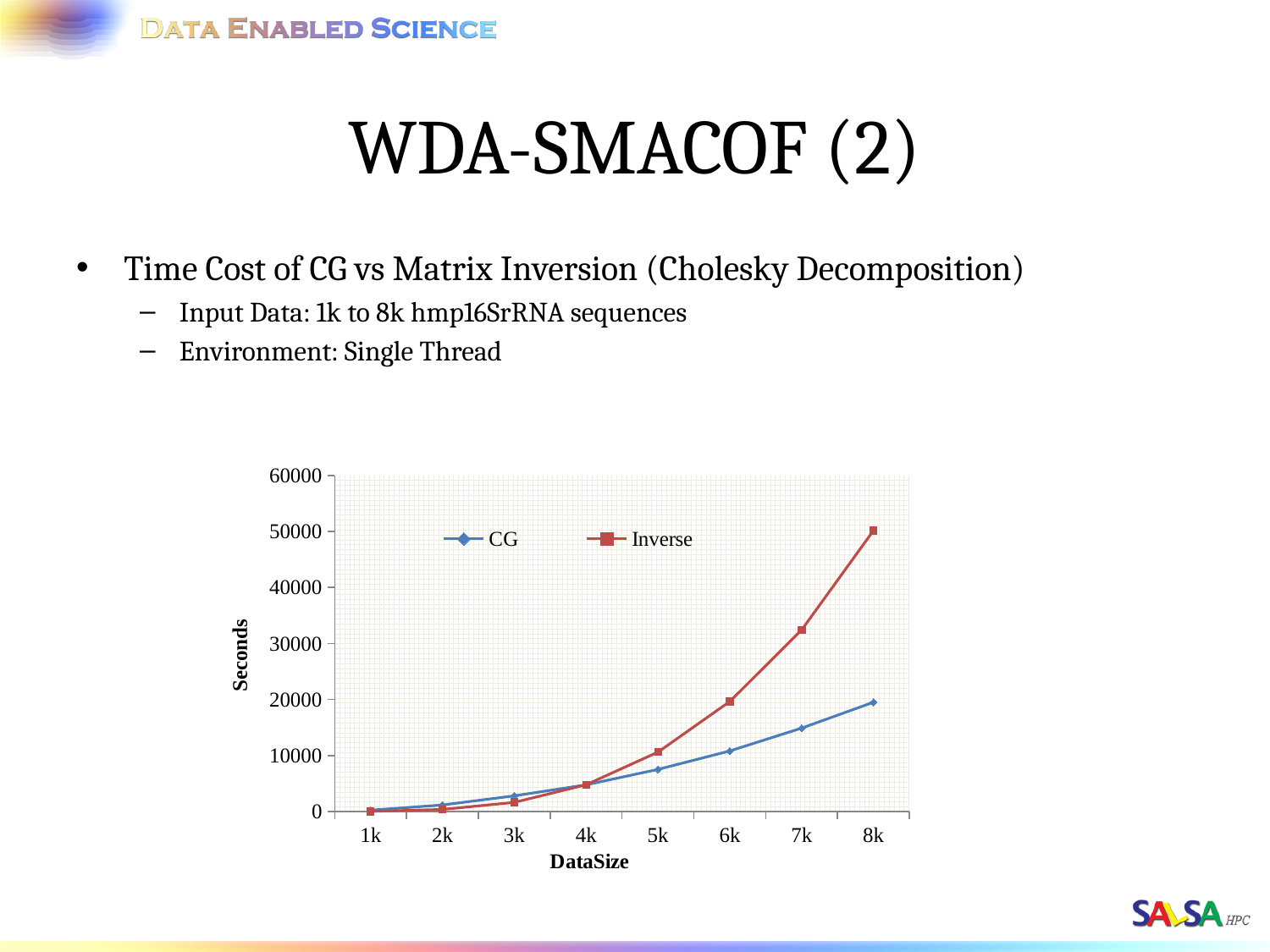
Do the values for Inverse rise or fall as the data size increases from 1k to 8k? rise What kind of chart is shown on the slide? line chart What are the names of the two series in the chart's legend? CG and Inverse Is the value for Inverse at 7k greater or less than 30000? greater At which data size does the Inverse series reach its highest value? 8k Is the value for Inverse at 8k greater or less than 40000? greater How many data sizes are plotted along the x axis of the chart? 8 Is the value for CG at 5k greater or less than 10000? less What is the label of the y axis of the chart? Seconds How many series does the chart's legend list? 2 At 8k, which series has the larger value, CG or Inverse? Inverse